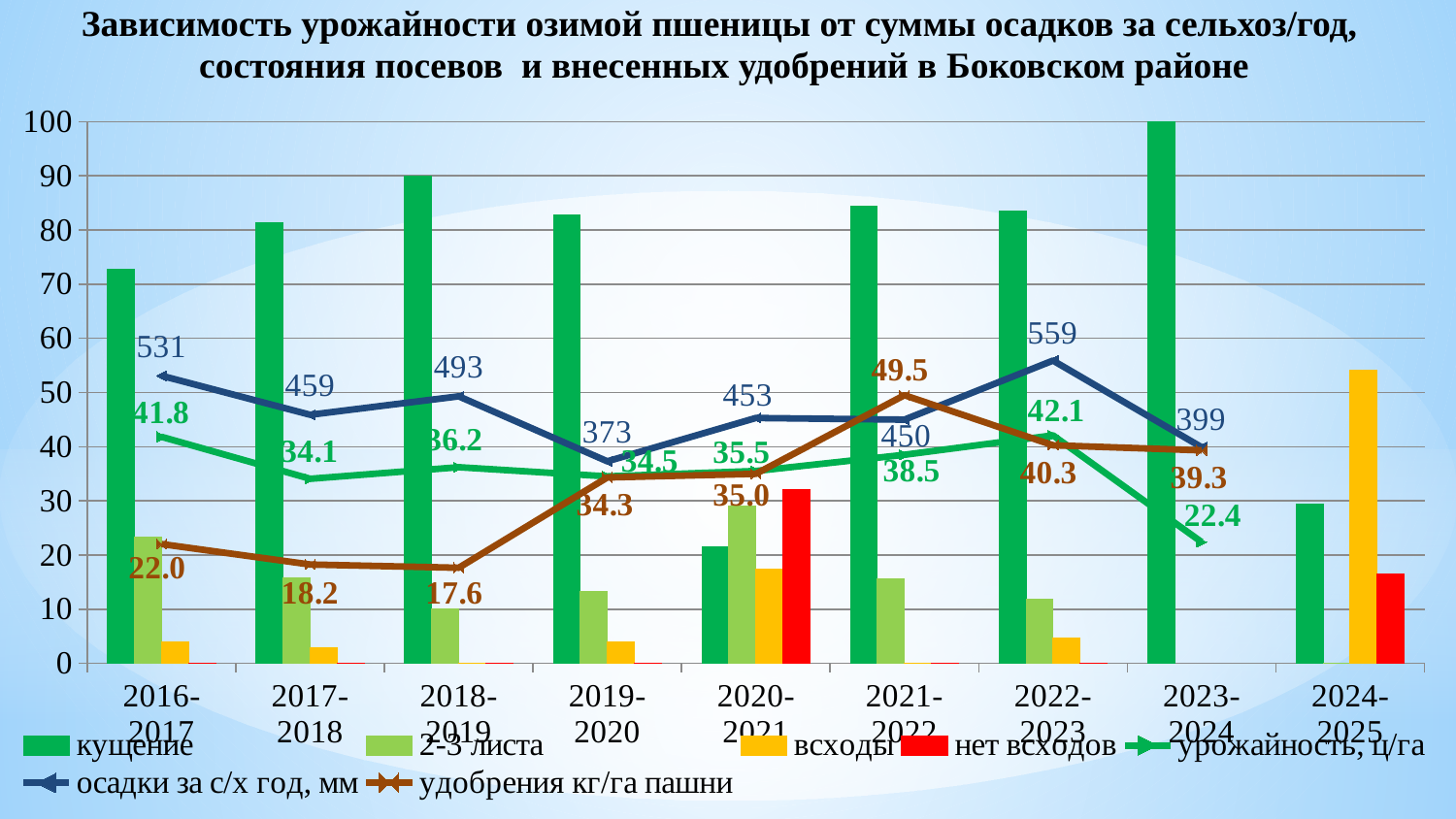
How many series does the legend list? 7 In which season is удобрения кг/га пашни the lowest? 2018-2019 What is the удобрения кг/га пашни value for 2021-2022? 49.5 Is the кущение bar for 2018-2019 greater or less than 80? greater What is the difference in осадки за с/х год, мм between 2022-2023 and 2023-2024? 160 In which season is осадки за с/х год, мм the highest? 2022-2023 Which season has the larger удобрения кг/га пашни value, 2019-2020 or 2020-2021? 2020-2021 What is the value of осадки за с/х год, мм for 2016-2017? 531 What kind of chart is this? Combined bar and line chart In which season is урожайность, ц/га the lowest? 2023-2024 How many seasons are shown on the x axis? 9 What is the урожайность, ц/га value for 2022-2023? 42.1